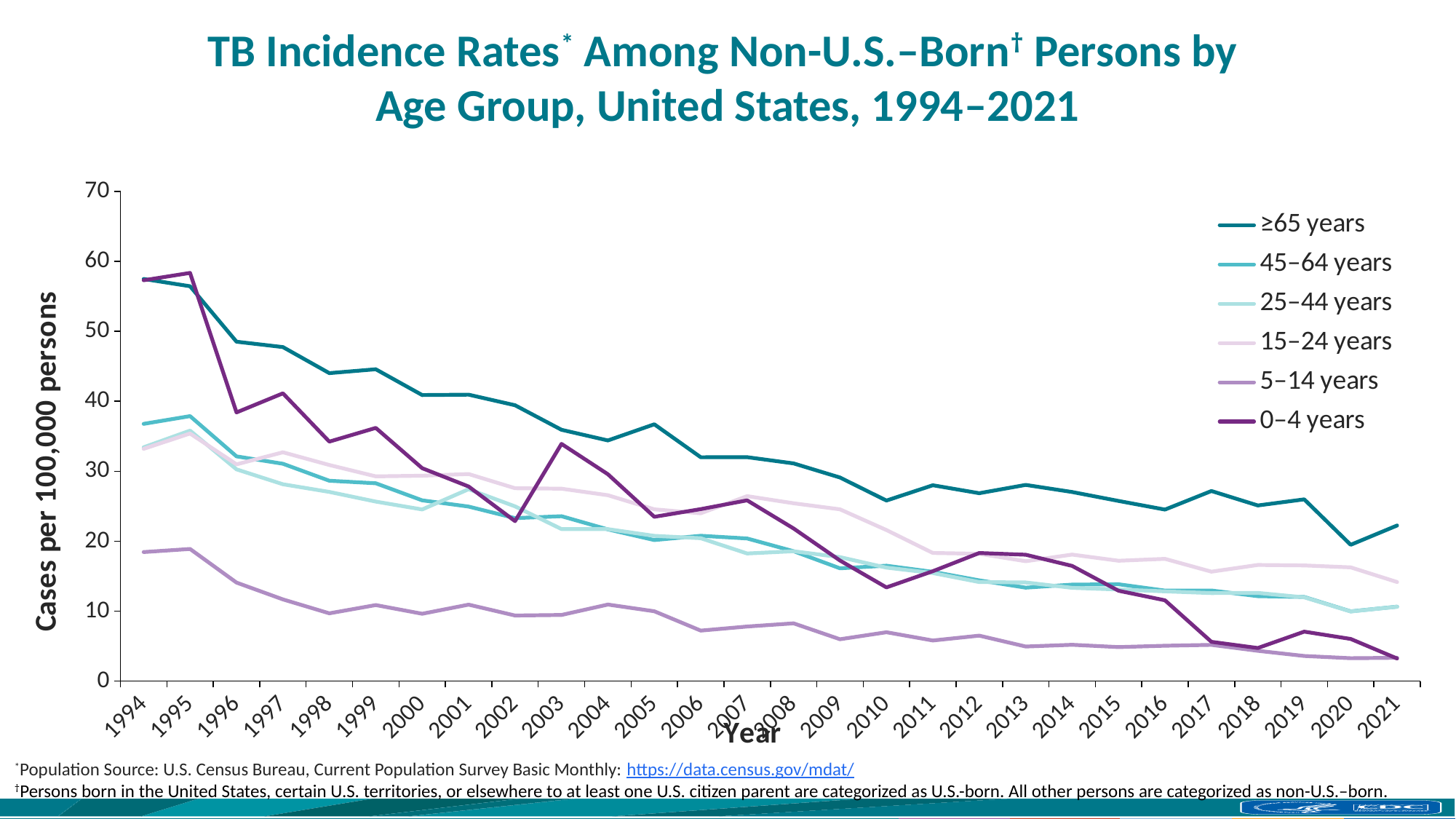
Which age group is listed first in the legend? ≥65 years Is the value for ≥65 years in 1994 greater or less than 50? greater How many years are plotted along the x axis? 28 What is the label of the y axis? Cases per 100,000 persons How many series does the legend list? 6 Does the ≥65 years series generally rise or fall from 1994 to 2021? fall Is the value for 5–14 years in 1994 greater or less than 20? less What kind of chart is shown on the slide? line chart Is the value for 0–4 years in 2021 greater or less than 10? less In 1996, which is larger: the value for ≥65 years or the value for 0–4 years? ≥65 years Which age group has the highest incidence rate in 2021? ≥65 years